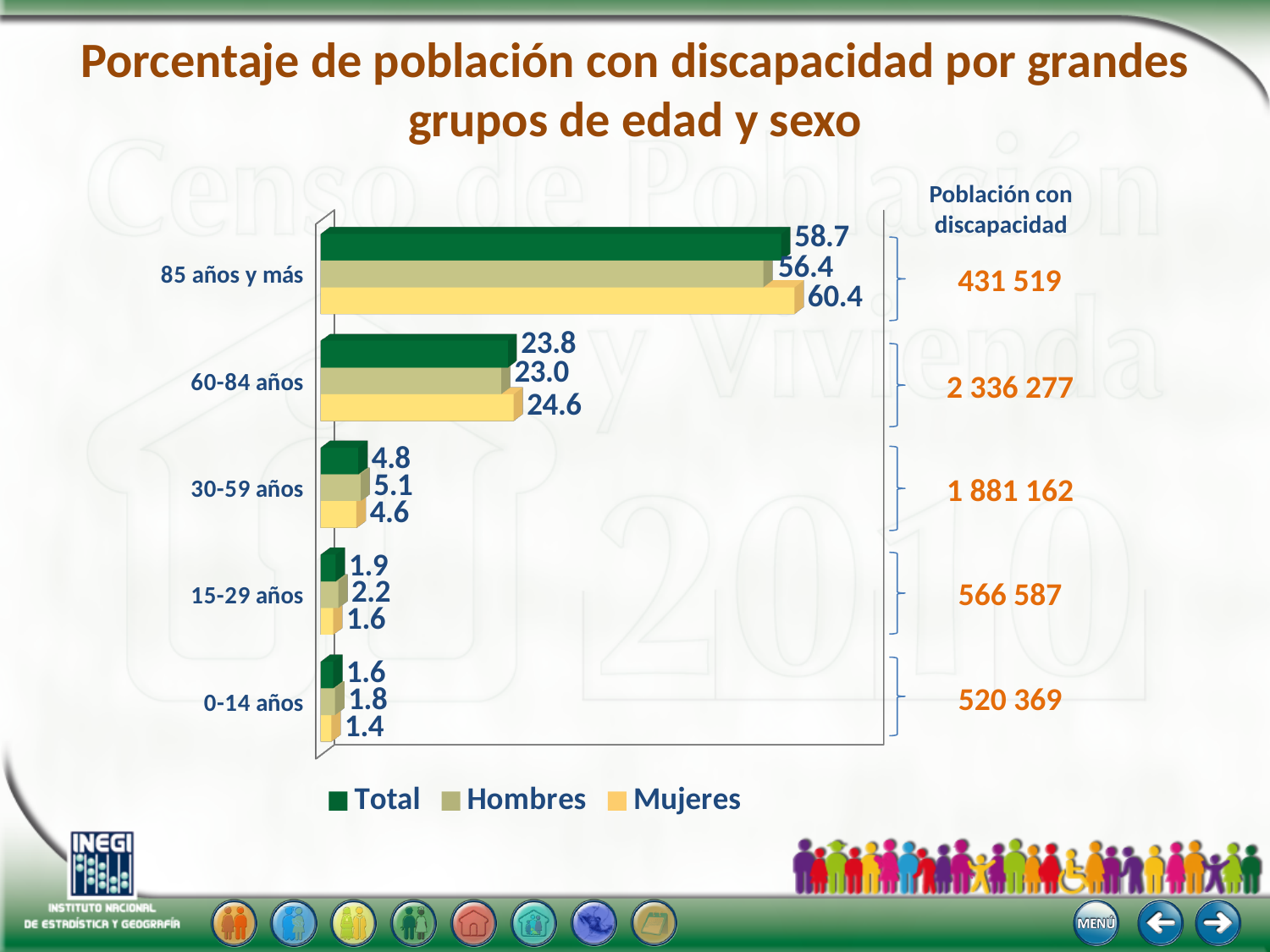
How many age groups are shown on the chart? 5 What kind of chart is shown on the slide? Bar chart Which age group has the highest Total value? 85 años y más What is the difference between the Mujeres and Hombres values for the 85 años y más age group? 4.0 How many series does the legend list? 3 For the 15-29 años age group, which is larger, the Hombres value or the Mujeres value? Hombres What is the Hombres value for the 30-59 años age group? 5.1 What is the Mujeres value for the 60-84 años age group? 24.6 What is the Población con discapacidad figure shown next to the 60-84 años age group? 2 336 277 Which age group has the lowest Mujeres value? 0-14 años What is the Total value for the 85 años y más age group? 58.7 What is the Mujeres value for the 0-14 años age group? 1.4